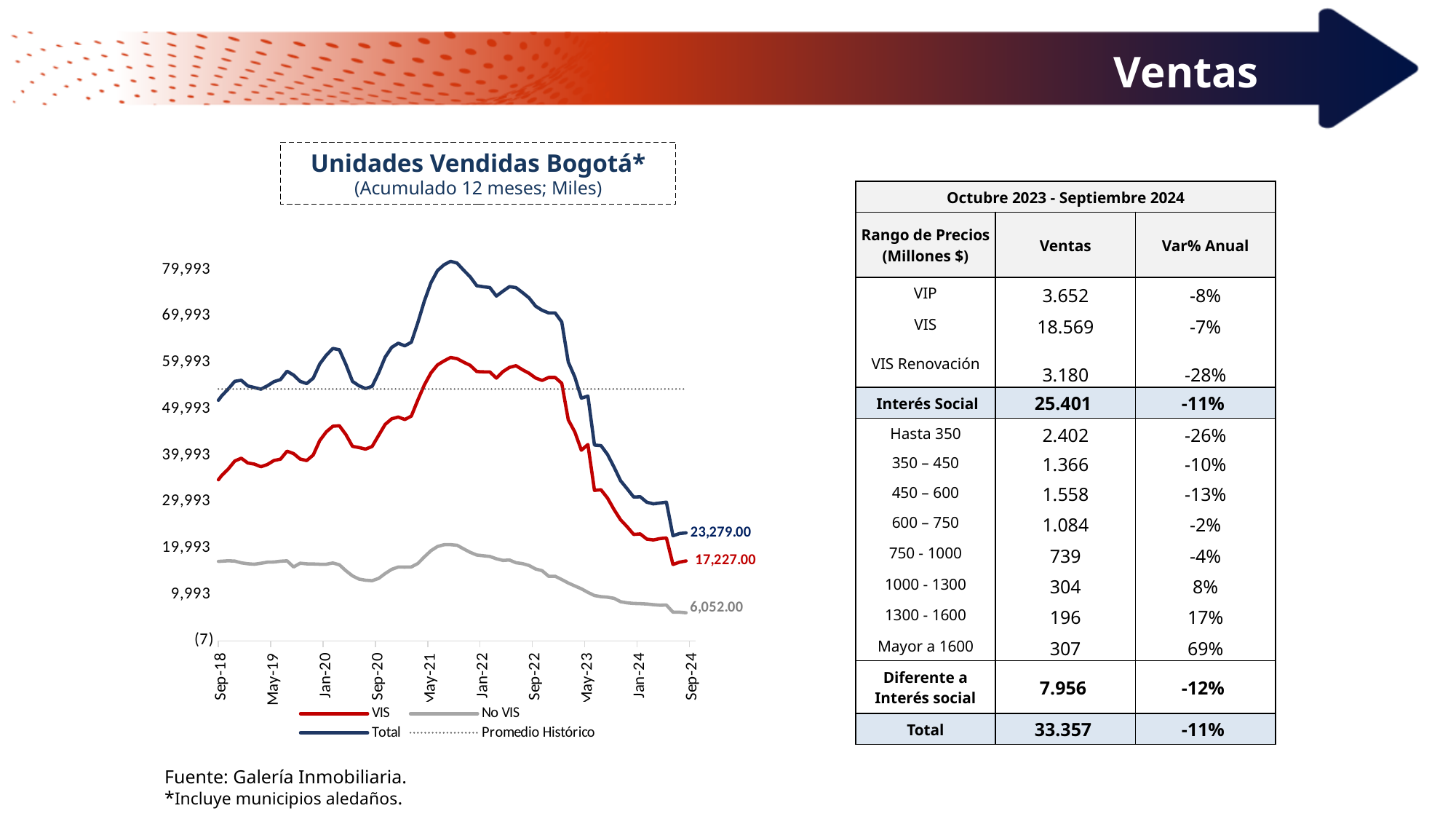
What is the value of the VIS series at Sep-24 in the "Unidades Vendidas Bogotá*" chart? 17,227.00 In the "Unidades Vendidas Bogotá*" chart, is the Total value at Jan-20 greater or less than 49,993? greater In the "Unidades Vendidas Bogotá*" chart, which legend entry is drawn as a dotted line? Promedio Histórico In the "Unidades Vendidas Bogotá*" chart, what is the difference between the Total and VIS values at Sep-24? 6,052.00 What kind of chart is shown under the title "Unidades Vendidas Bogotá*"? line chart In the "Unidades Vendidas Bogotá*" chart, does the Total series rise or fall between May-23 and Sep-24? fall In the "Unidades Vendidas Bogotá*" chart, what is the difference between the VIS and No VIS values at Sep-24? 11,175.00 In the "Unidades Vendidas Bogotá*" chart, which is larger at Sep-24: VIS or No VIS? VIS What is the value of the Total series at Sep-24 in the "Unidades Vendidas Bogotá*" chart? 23,279.00 What is the value of the No VIS series at Sep-24 in the "Unidades Vendidas Bogotá*" chart? 6,052.00 Which series has the highest value at Sep-24 in the "Unidades Vendidas Bogotá*" chart? Promedio Histórico How many series does the legend of the "Unidades Vendidas Bogotá*" chart list? 4